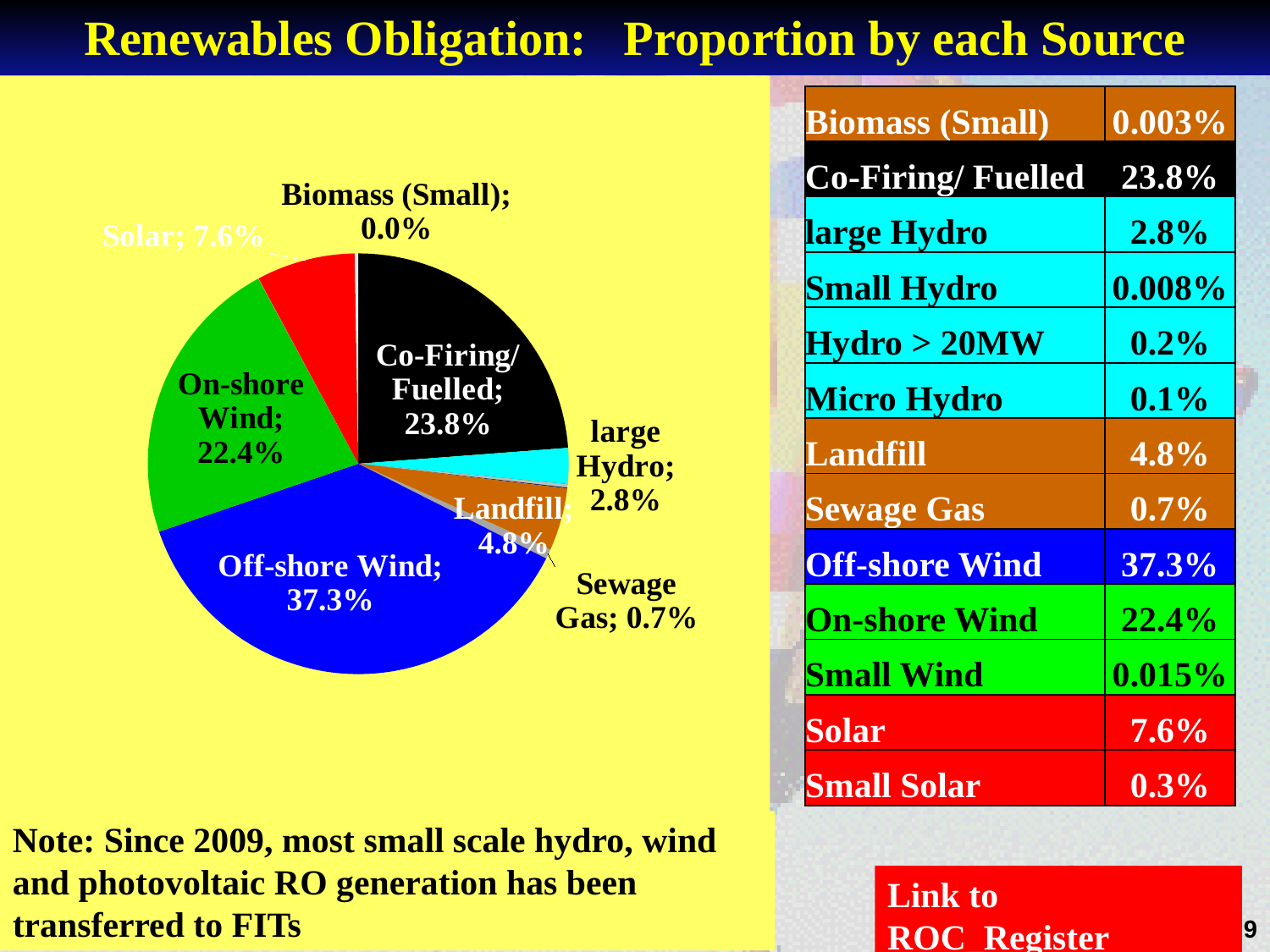
What is the value shown for Landfill in the pie chart? 4.8% How many labelled slices does the pie chart have? 8 What is the value shown for Co-Firing/Fuelled in the pie chart? 23.8% What type of chart is shown on the slide? pie chart Which source has the largest slice of the pie chart? Off-shore Wind Which labelled source has the smallest slice of the pie chart? Biomass (Small) What is the value shown for Solar in the pie chart? 7.6% What is the value shown for On-shore Wind in the pie chart? 22.4% What share of the pie does Off-shore Wind have? 37.3% Which is larger in the pie chart, large Hydro or Landfill? Landfill What is the difference between the Off-shore Wind and On-shore Wind shares in the pie chart? 14.9% What is the value shown for Sewage Gas in the pie chart? 0.7%